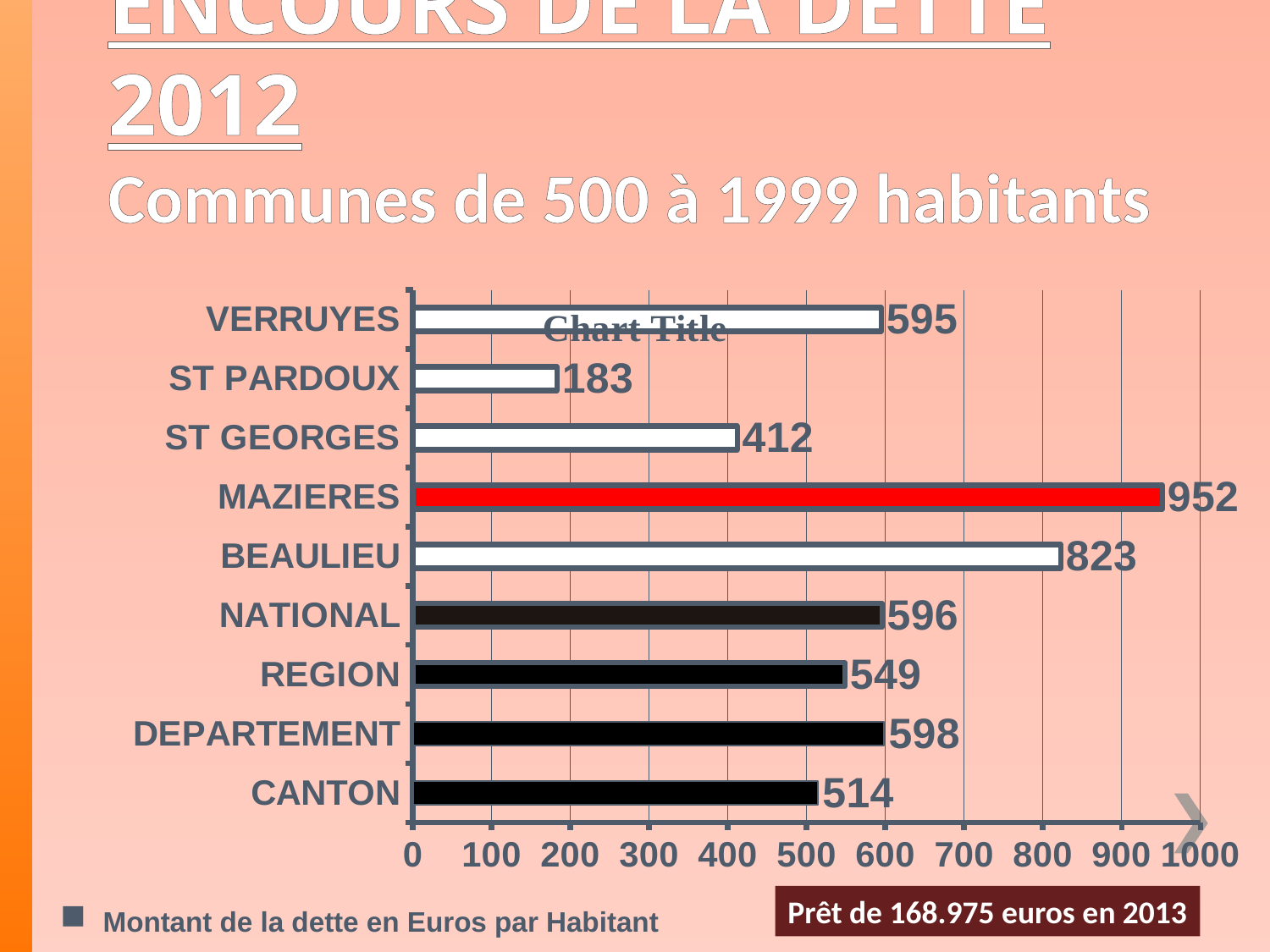
Is the value for CANTON greater or less than 600? less Which category has the lowest value? ST PARDOUX Which bar is coloured red? MAZIERES Which is larger, the value for VERRUYES or the value for ST GEORGES? VERRUYES Which category has the highest value? MAZIERES What is the value for ST PARDOUX? 183 What kind of chart is shown on the slide? bar chart What is the value for MAZIERES? 952 What is the difference between the values for ST GEORGES and ST PARDOUX? 229 What is the difference between the values for MAZIERES and BEAULIEU? 129 What is the value for BEAULIEU? 823 How many categories are shown on the chart? 9